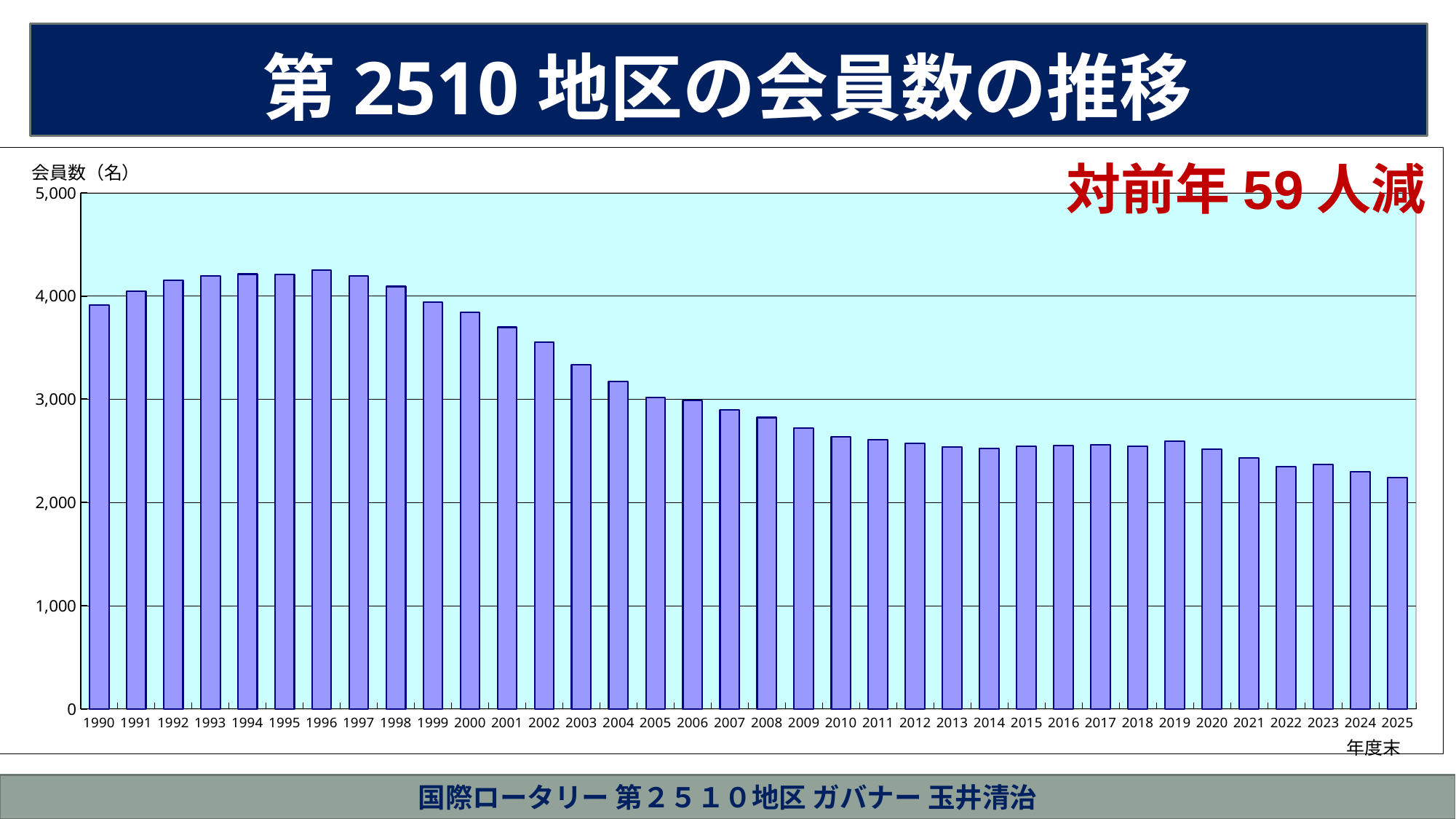
Is the membership count for 2025 greater or less than 2,000? greater What kind of chart is shown on the slide? Bar chart Overall, does the membership count rise or fall from 1996 to 2025? Fall What does the red annotation at the top right of the chart say? 対前年59人減 Is the membership count for 2010 greater or less than 3,000? less Which year has the lowest membership count? 2025 Is the membership count for 1990 greater or less than 3,000? greater Which year has the larger membership count, 2000 or 2010? 2000 What is the title of the chart on the slide? 第2510地区の会員数の推移 How many years (bars) are plotted on the chart? 36 Which year has the larger membership count, 1990 or 2025? 1990